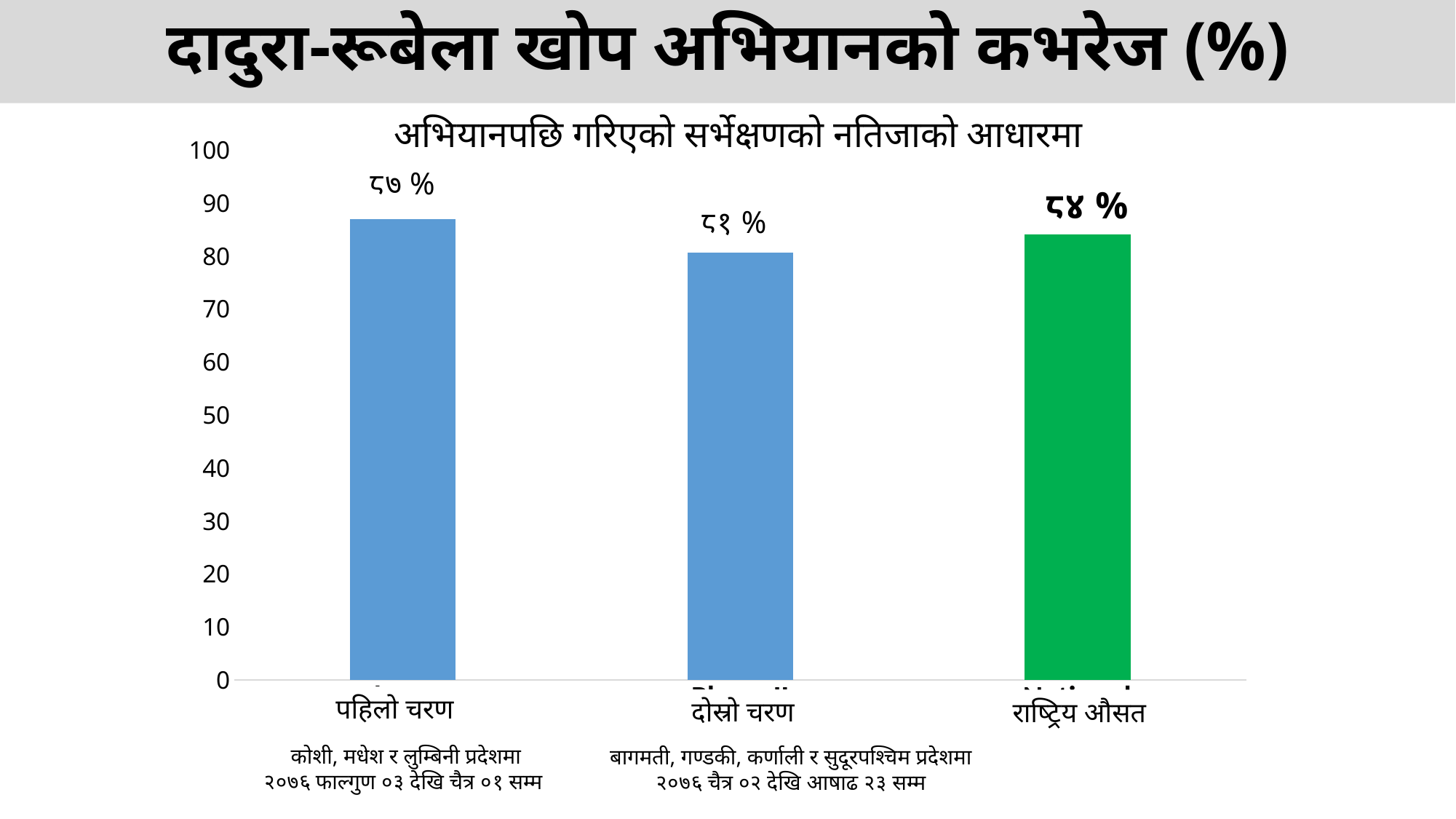
What is the difference between the values for पहिलो चरण and दोस्रो चरण? ६ % What kind of chart is shown on the slide? bar chart What is the value shown for दोस्रो चरण? ८१ % What is the value shown for पहिलो चरण? ८७ % How many bars are shown in the chart? 3 What is the value shown for राष्ट्रिय औसत? ८४ % Which is larger, the value for पहिलो चरण or the value for राष्ट्रिय औसत? पहिलो चरण Is the value for दोस्रो चरण greater or less than 90? less Which category has the lowest value? दोस्रो चरण Which category has the highest value? पहिलो चरण What colour is the bar for राष्ट्रिय औसत? green What is the title of the slide? दादुरा-रूबेला खोप अभियानको कभरेज (%)